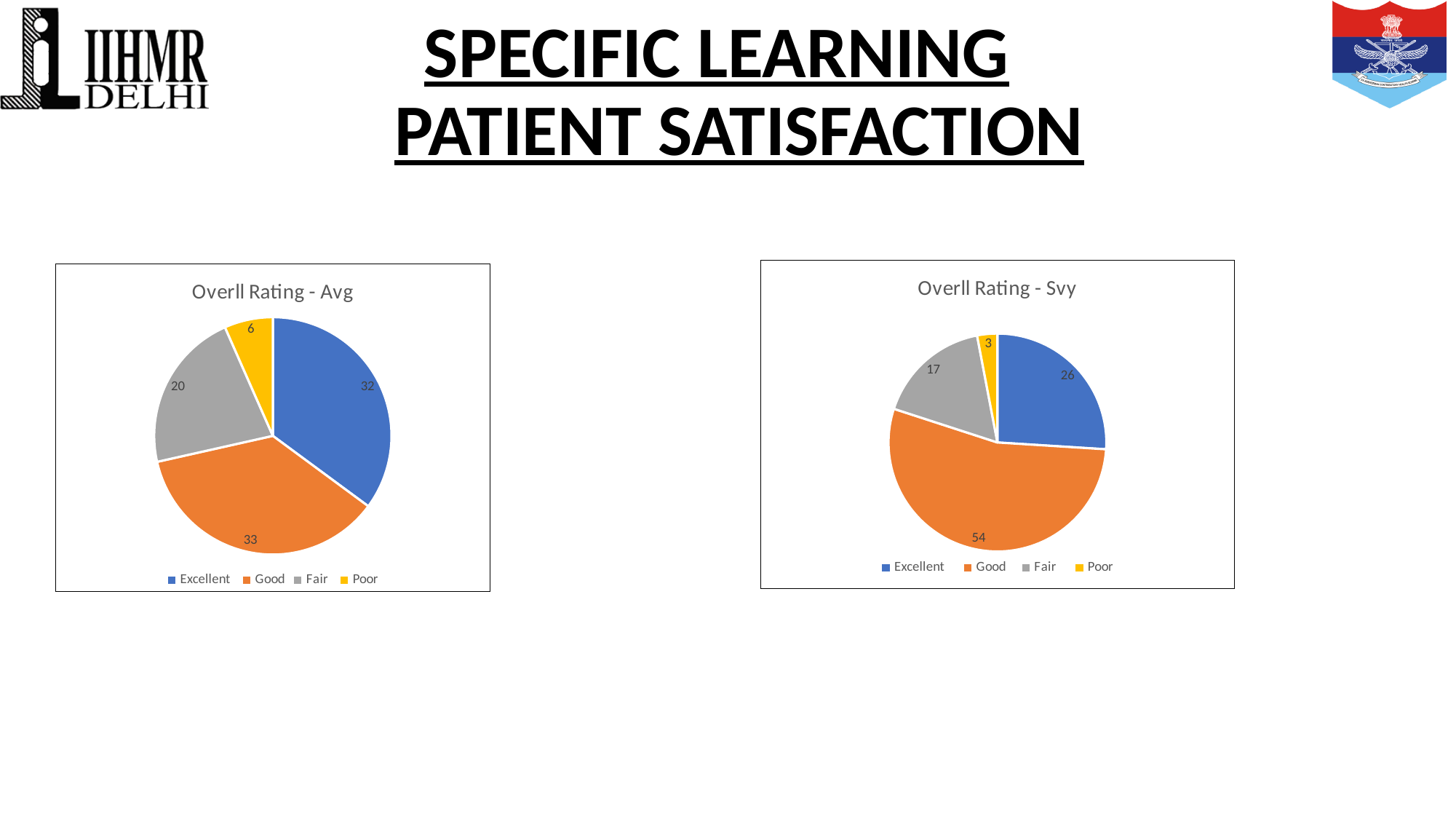
What type of chart is the left chart? Pie chart In the right pie chart (Overll Rating - Svy), what is the difference between the Good and Excellent values? 28 In the left pie chart, what is the difference between the Fair and Poor values? 14 In the right pie chart (Overll Rating - Svy), what is the value for Excellent? 26 In the left pie chart, which category has the smallest slice? Poor In the left pie chart, what is the value for Poor? 6 How many categories does the right pie chart (Overll Rating - Svy) show? 4 In the left pie chart, what is the value for Good? 33 In the right pie chart (Overll Rating - Svy), what share of the total does Good represent? 54% In the right pie chart (Overll Rating - Svy), what is the value for Fair? 17 In the left pie chart, which is larger, Fair or Poor? Fair In the right pie chart (Overll Rating - Svy), which category has the largest slice? Good